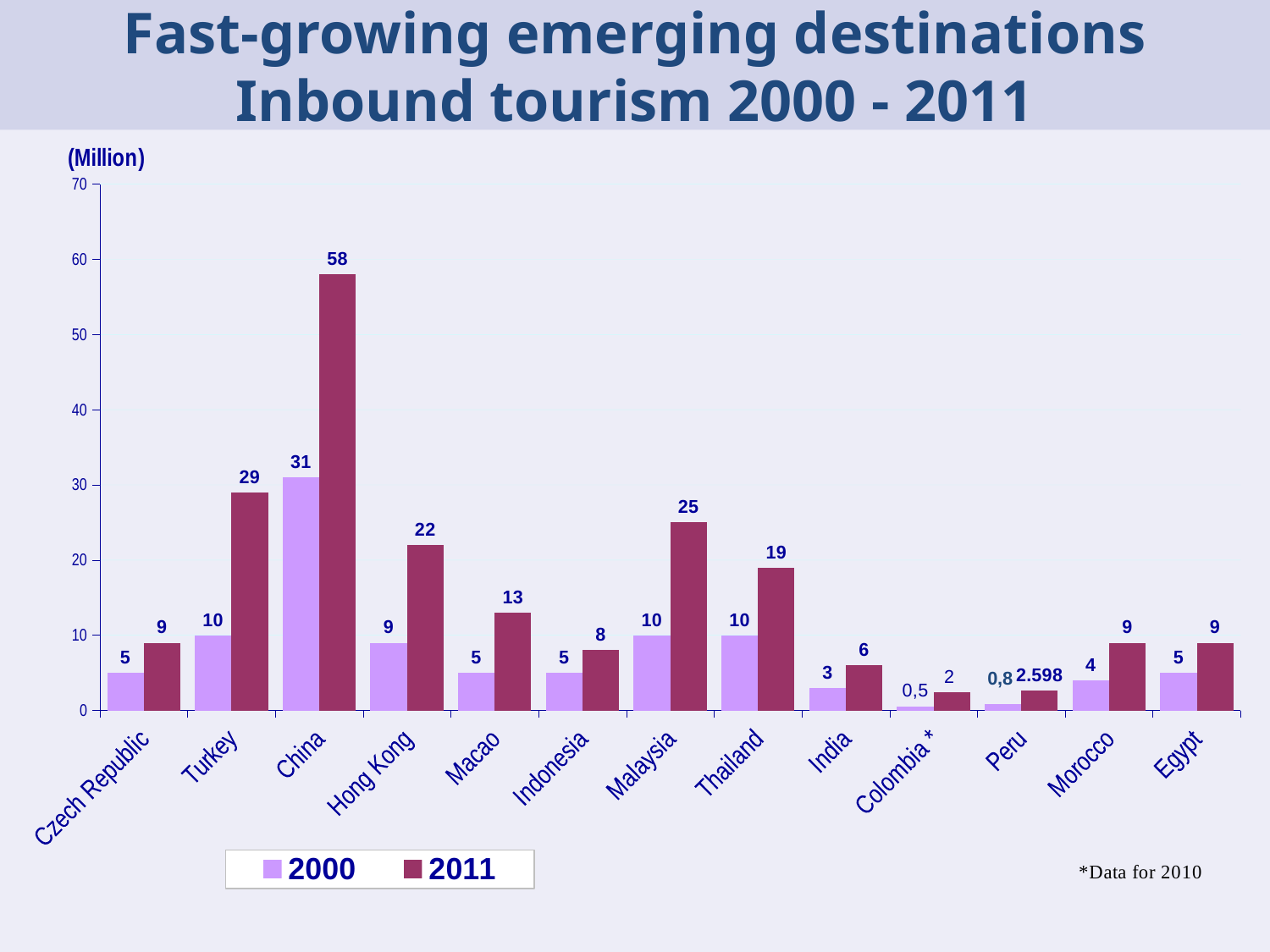
Is the 2011 value for Turkey greater or less than 20? greater What unit is indicated for the y axis? (Million) Which destination has the lowest 2000 value? Colombia * What is the difference between the 2011 and 2000 values for Malaysia? 15 Which destination has the highest 2011 value? China Which is larger, the 2011 value for Hong Kong or the 2011 value for Thailand? Hong Kong What is the 2011 value for Peru? 2.598 What is the 2011 value for China? 58 What is the 2000 value for Turkey? 10 How many destinations are shown on the x axis? 13 What kind of chart is shown on the slide? Bar chart How many series does the legend list? 2